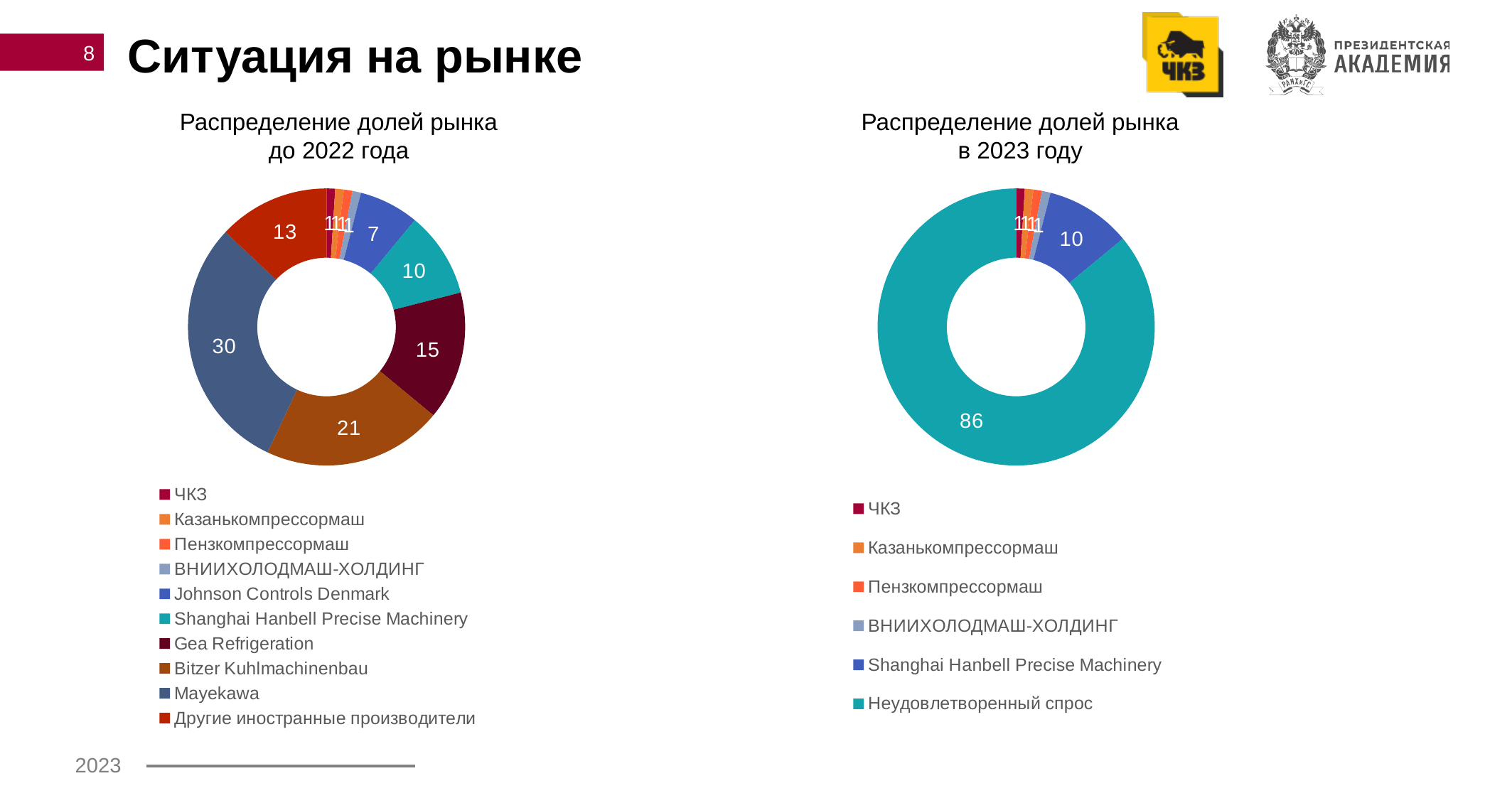
In the chart 'Распределение долей рынка до 2022 года', what is the value for Другие иностранные производители? 13 In the chart 'Распределение долей рынка в 2023 году', what is the value for Shanghai Hanbell Precise Machinery? 10 In the chart 'Распределение долей рынка до 2022 года', which is larger: Gea Refrigeration or Shanghai Hanbell Precise Machinery? Gea Refrigeration In the chart 'Распределение долей рынка до 2022 года', what is the value for Johnson Controls Denmark? 7 In the chart 'Распределение долей рынка до 2022 года', what is the value for Bitzer Kuhlmachinenbau? 21 In the chart 'Распределение долей рынка до 2022 года', what is the difference between the values for Mayekawa and Bitzer Kuhlmachinenbau? 9 In the chart 'Распределение долей рынка до 2022 года', which category has the largest slice? Mayekawa In the chart 'Распределение долей рынка до 2022 года', what is the value for Mayekawa? 30 How many categories does the legend of the chart 'Распределение долей рынка до 2022 года' list? 10 What type of chart is 'Распределение долей рынка в 2023 году'? Doughnut (pie) chart In the chart 'Распределение долей рынка в 2023 году', what is the value for Неудовлетворенный спрос? 86 In the chart 'Распределение долей рынка до 2022 года', what is the value for Gea Refrigeration? 15